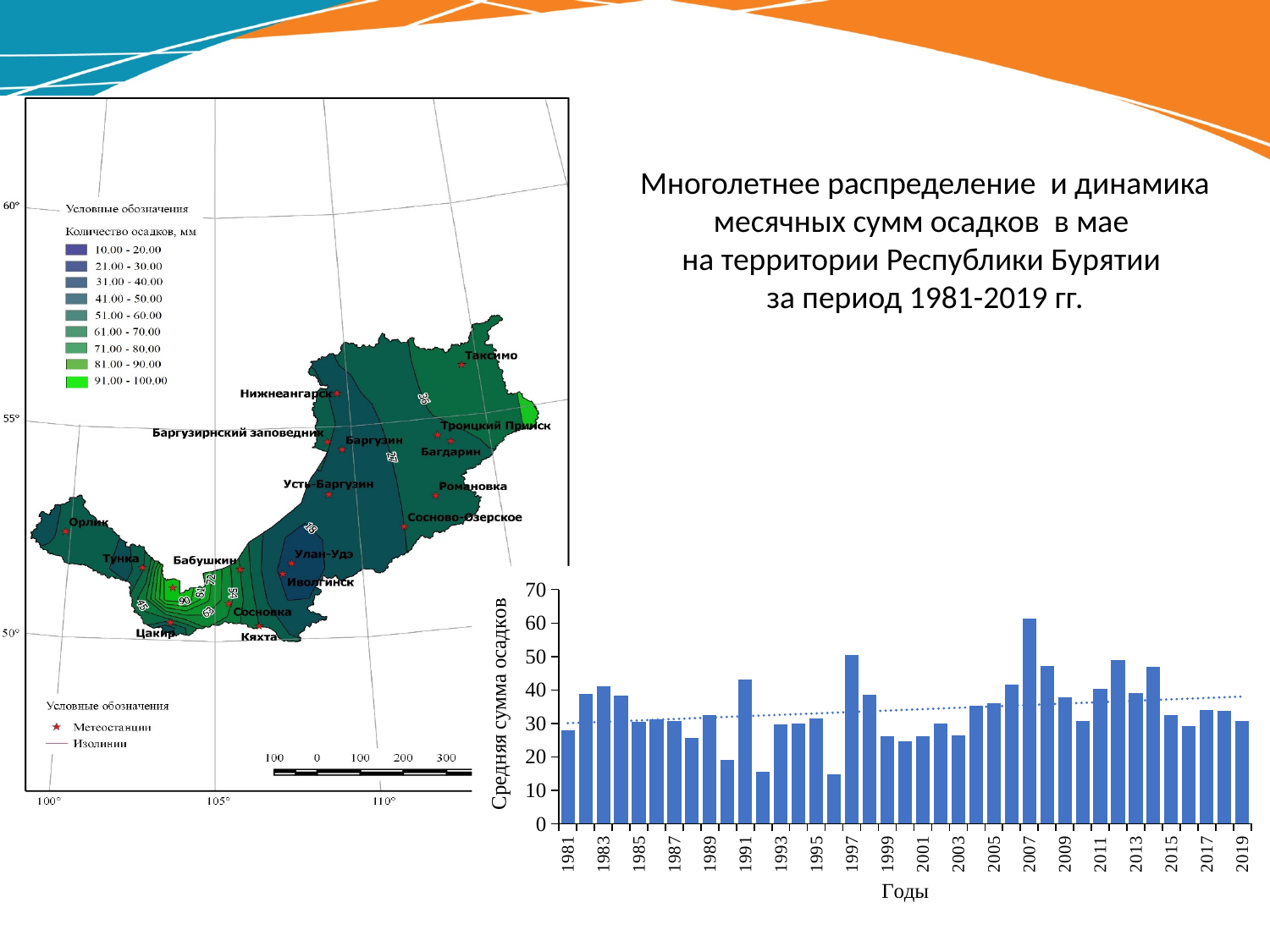
What is the label of the x axis of the bar chart? Годы In the bar chart, which year has the larger value, 2008 or 2010? 2008 According to the dotted trend line in the bar chart, do the values rise or fall from 1981 to 2019? rise In the bar chart, is the value for 2012 greater or less than 40? greater In the bar chart, which year has the larger value, 1991 or 1992? 1991 In the bar chart, is the value for 2007 greater or less than 60? greater In the bar chart, which year has the highest average monthly precipitation sum? 2007 What kind of chart is shown at the bottom right of the slide? bar chart How many years (bars) are plotted in the bar chart? 39 In the bar chart, is the value for 1996 greater or less than 20? less